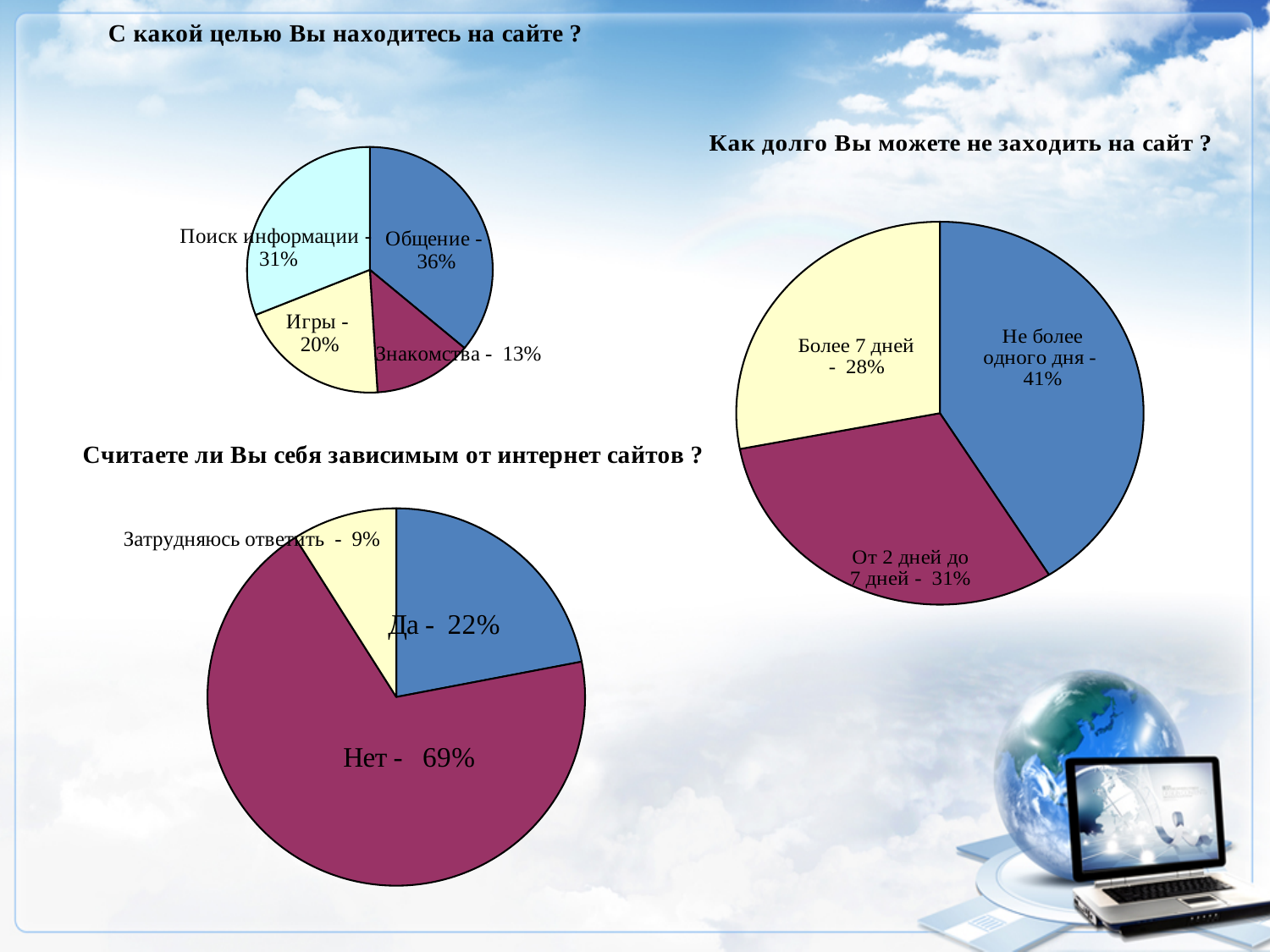
In the pie chart titled "С какой целью Вы находитесь на сайте ?", what is the difference between the shares for "Поиск информации" and "Игры"? 11% In the pie chart titled "Считаете ли Вы себя зависимым от интернет сайтов ?", what share is labelled for "Затрудняюсь ответить"? 9% What type of chart is used for "Считаете ли Вы себя зависимым от интернет сайтов ?"? Pie chart In the pie chart titled "С какой целью Вы находитесь на сайте ?", what share is labelled for "Общение"? 36% In the pie chart titled "С какой целью Вы находитесь на сайте ?", how many slices does the pie have? 4 In the pie chart titled "Как долго Вы можете не заходить на сайт ?", what share is labelled for "Более 7 дней"? 28% In the pie chart titled "Как долго Вы можете не заходить на сайт ?", which is larger: "От 2 дней до 7 дней" or "Более 7 дней"? От 2 дней до 7 дней In the pie chart titled "Как долго Вы можете не заходить на сайт ?", which category has the largest slice? Не более одного дня In the pie chart titled "С какой целью Вы находитесь на сайте ?", which category has the smallest slice? Знакомства In the pie chart titled "Считаете ли Вы себя зависимым от интернет сайтов ?", what share is labelled for "Нет"? 69% In the pie chart titled "Считаете ли Вы себя зависимым от интернет сайтов ?", what is the difference between the shares for "Нет" and "Да"? 47% How many pie charts are shown on the slide? 3